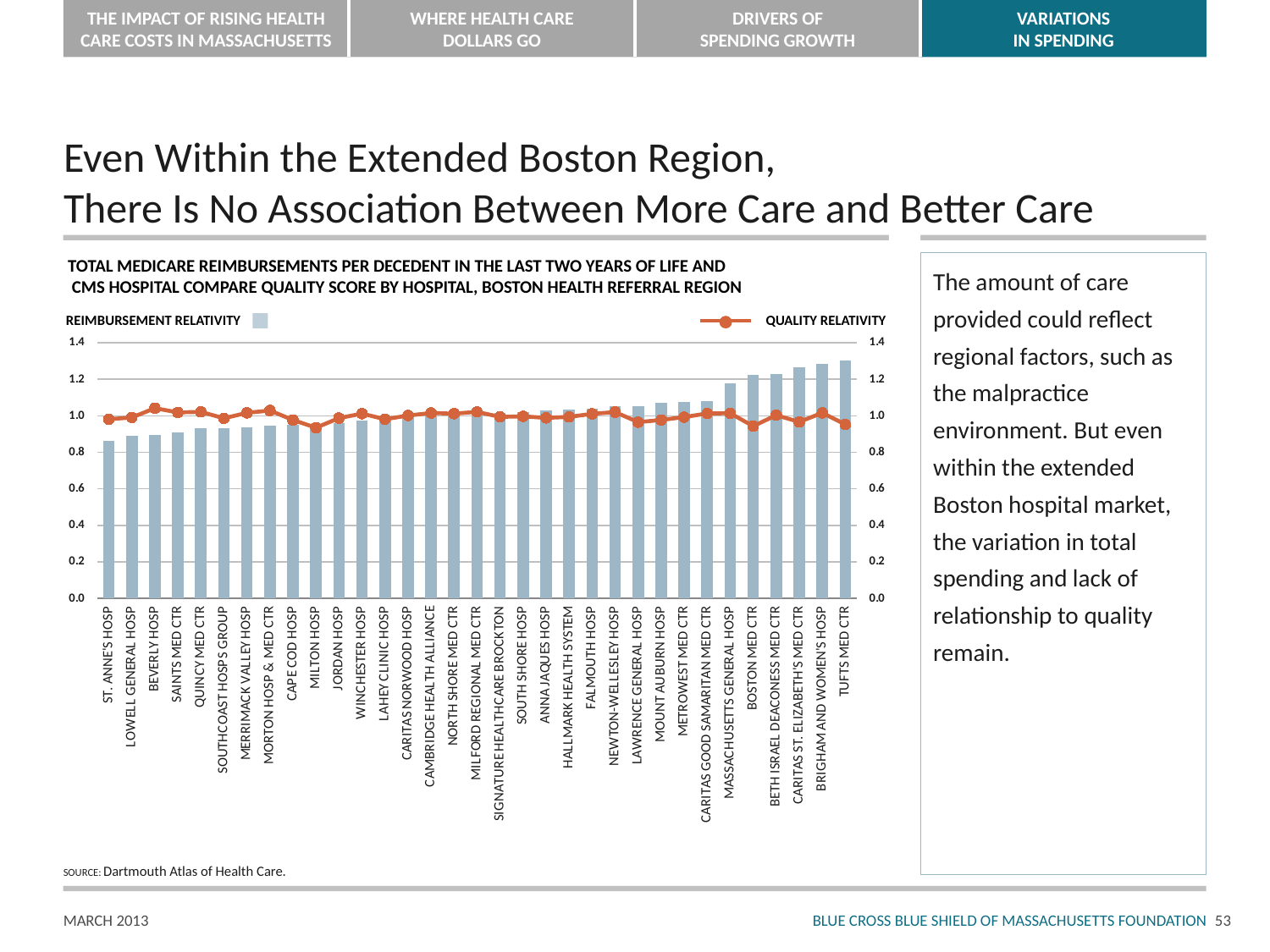
How many hospitals are shown along the x axis? 33 Which series is plotted as the orange line with markers? Quality relativity How many series does the legend list? 2 Is the reimbursement relativity for Brigham and Women's Hosp greater or less than 1.2? greater Is the reimbursement relativity for St. Anne's Hosp greater or less than 1.0? less Which hospital has the lowest reimbursement relativity bar? St. Anne's Hosp Do the reimbursement relativity bars rise or fall from left to right across the x axis? Rise Which has the larger reimbursement relativity bar, Massachusetts General Hosp or Cape Cod Hosp? Massachusetts General Hosp What kind of chart is shown on the slide? A combined bar and line chart Is the reimbursement relativity for Tufts Med Ctr greater or less than 1.2? greater Which hospital has the highest reimbursement relativity bar? Tufts Med Ctr